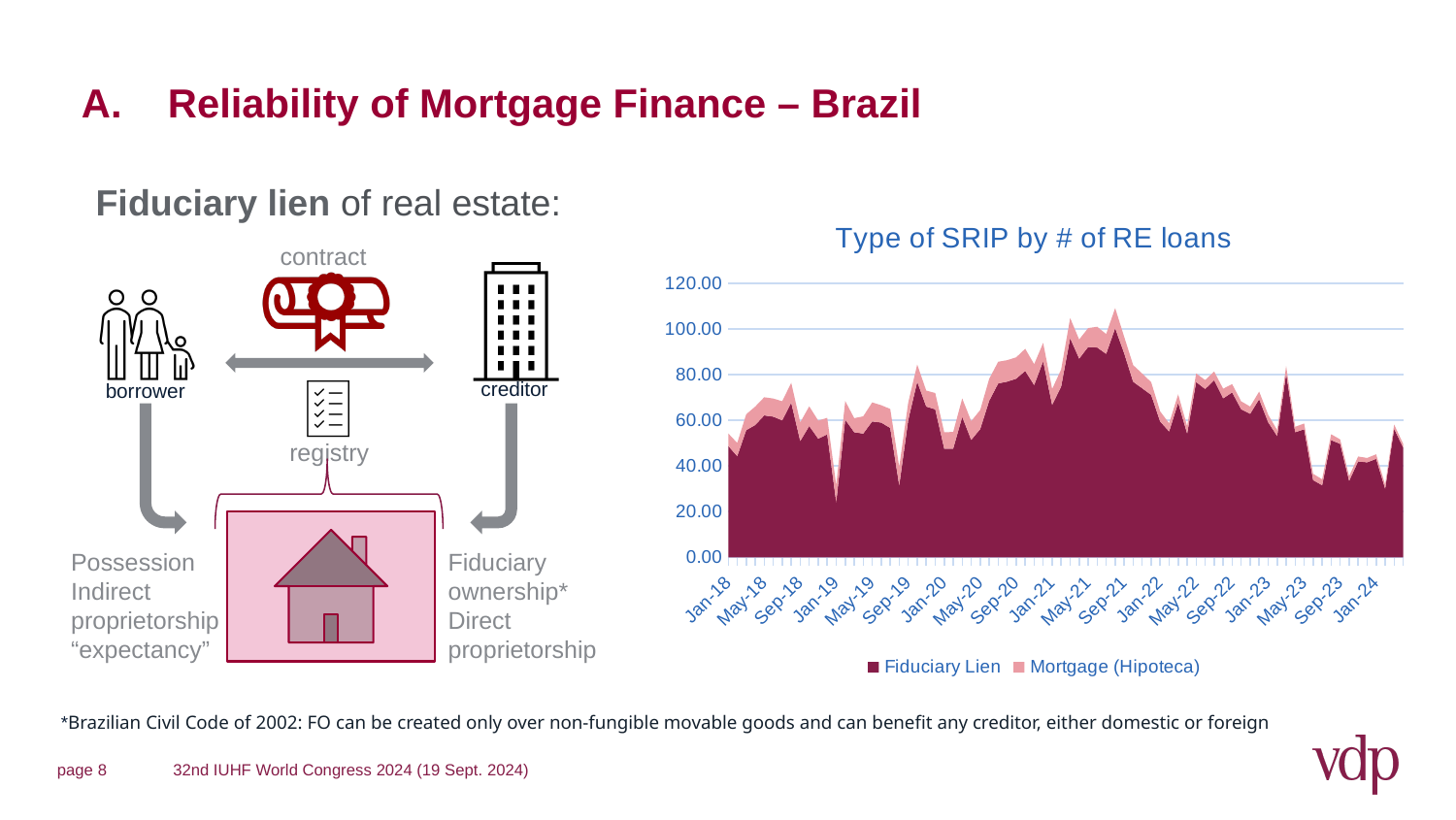
Which two series are shown in the chart's legend? Fiduciary Lien and Mortgage (Hipoteca) Which series accounts for the larger share of RE loans throughout the chart, Fiduciary Lien or Mortgage (Hipoteca)? Fiduciary Lien Is the total value at Jan-19 greater or less than 60? less How many series does the chart's legend list? 2 Do the values generally rise or fall between Jan-18 and Sep-21? rise What is the title of the chart on the slide? Type of SRIP by # of RE loans Is the total value around Sep-21 greater or less than 80? greater What is the first month label on the chart's horizontal axis? Jan-18 What kind of chart is shown on the slide? Stacked area chart Do the values generally rise or fall between Sep-21 and Jan-24? fall What is the highest value shown on the chart's vertical axis? 120.00 Is the total value at Jan-24 greater or less than 80? less